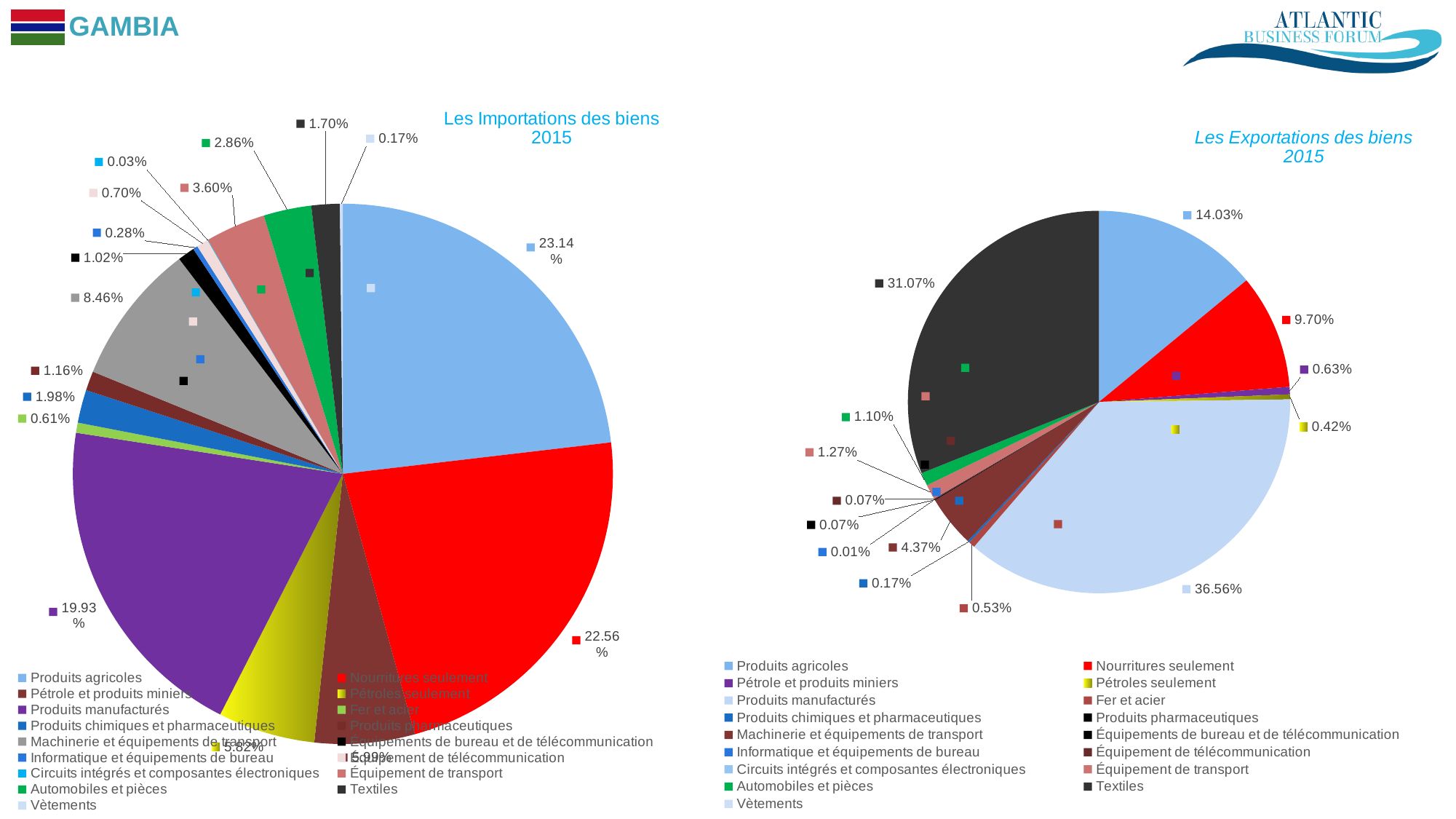
In "Les Exportations des biens 2015", what is the share of Produits agricoles? 14.03% In "Les Importations des biens 2015", which category has the largest share? Produits agricoles What kind of chart is "Les Importations des biens 2015"? pie chart In "Les Exportations des biens 2015", which is larger: the share of Produits agricoles or the share of Nourritures seulement? Produits agricoles In "Les Importations des biens 2015", what is the share of Produits manufacturés? 19.93% In "Les Exportations des biens 2015", what is the share of Textiles? 31.07% In "Les Importations des biens 2015", what is the share of Nourritures seulement? 22.56% In "Les Exportations des biens 2015", which category has the largest share? Produits manufacturés In "Les Exportations des biens 2015", what is the share of Produits manufacturés? 36.56% In "Les Importations des biens 2015", what is the difference between the shares of Produits agricoles and Nourritures seulement? 0.58% In "Les Importations des biens 2015", what is the share of Produits agricoles? 23.14% How many categories does the legend of "Les Exportations des biens 2015" list? 17